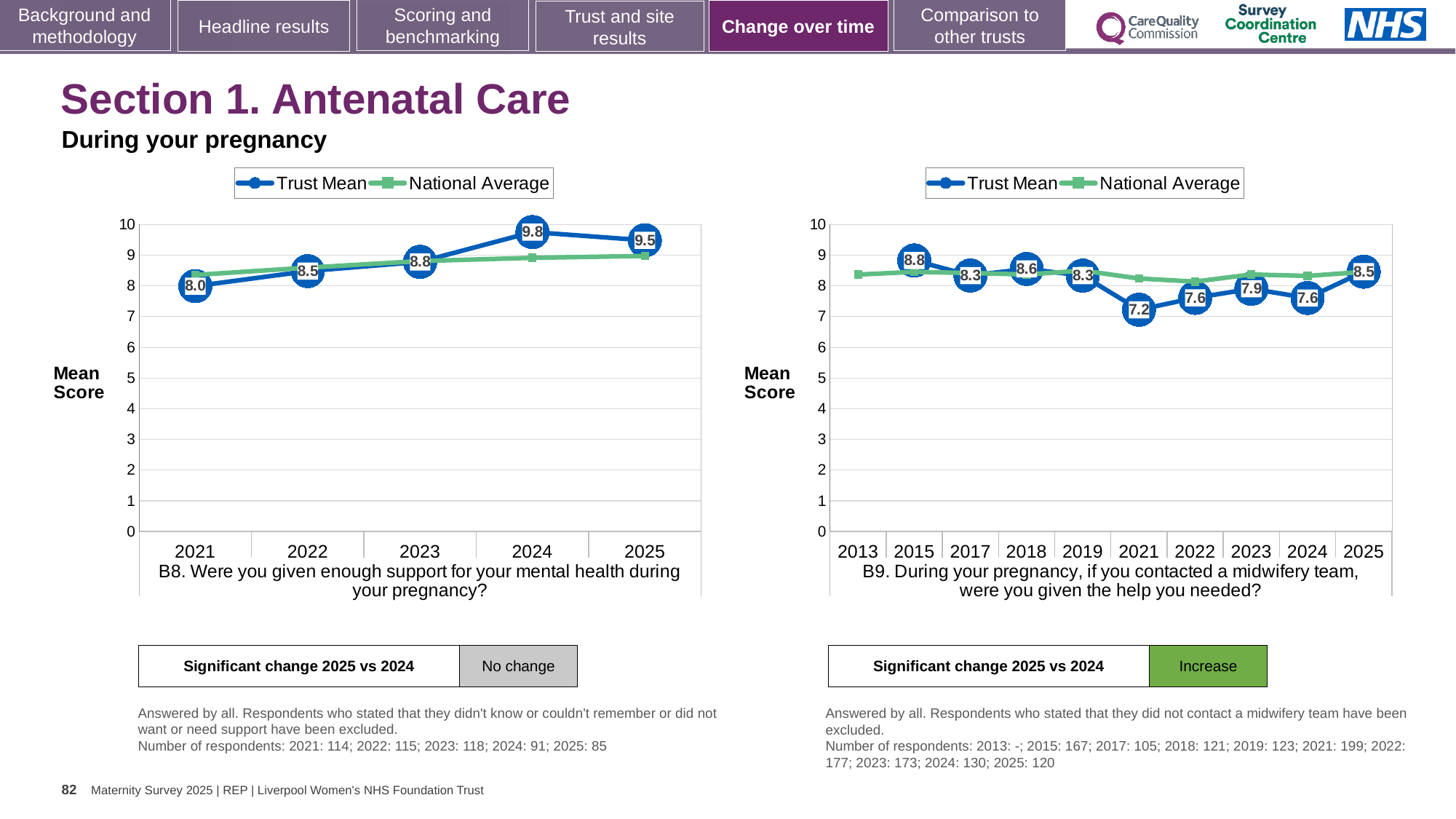
In the right chart (B9), which year has the lowest Trust Mean? 2021 In the left chart (B8), what is the Trust Mean for 2021? 8.0 In the left chart (B8), how many years are shown on the x axis? 5 In the right chart (B9), is the Trust Mean higher in 2018 or in 2022? 2018 In the right chart (B9), how many series does the legend list? 2 In the right chart (B9), what is the Trust Mean for 2025? 8.5 In the right chart (B9), what is the Trust Mean for 2021? 7.2 In the left chart (B8), what is the difference between the Trust Mean in 2024 and in 2021? 1.8 In the right chart (B9), which year has the highest Trust Mean? 2015 What type of chart is the left chart (B8)? Line chart In the left chart (B8), which year has the highest Trust Mean? 2024 In the left chart (B8), what is the Trust Mean for 2024? 9.8